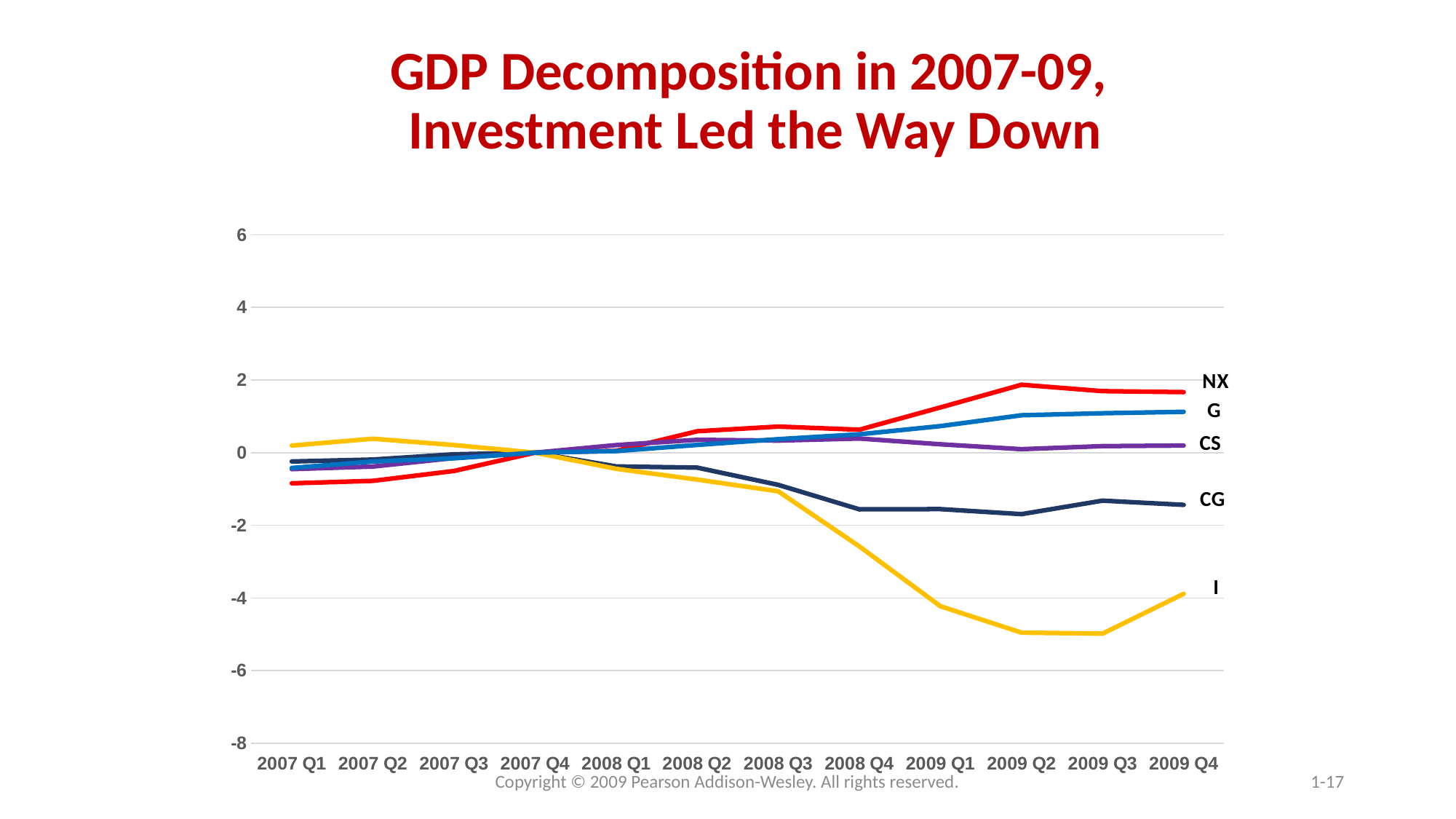
Is the value for I in 2009 Q2 greater or less than -4? less Which series has the highest value in 2009 Q2? NX In 2009 Q4, which is larger, G or CS? G Does the I series rise or fall from 2008 Q3 to 2009 Q2? fall How many quarters are shown along the x axis of the chart? 12 Does the NX series rise or fall from 2007 Q1 to 2009 Q2? rise Is the value for CG in 2009 Q1 greater or less than -1? less How many series are labelled on the chart? 5 What is the title of the chart? GDP Decomposition in 2007-09, Investment Led the Way Down Which series has the lowest value in 2009 Q2? I What kind of chart is shown on the slide? line chart Is the value for NX in 2009 Q2 greater or less than 1? greater